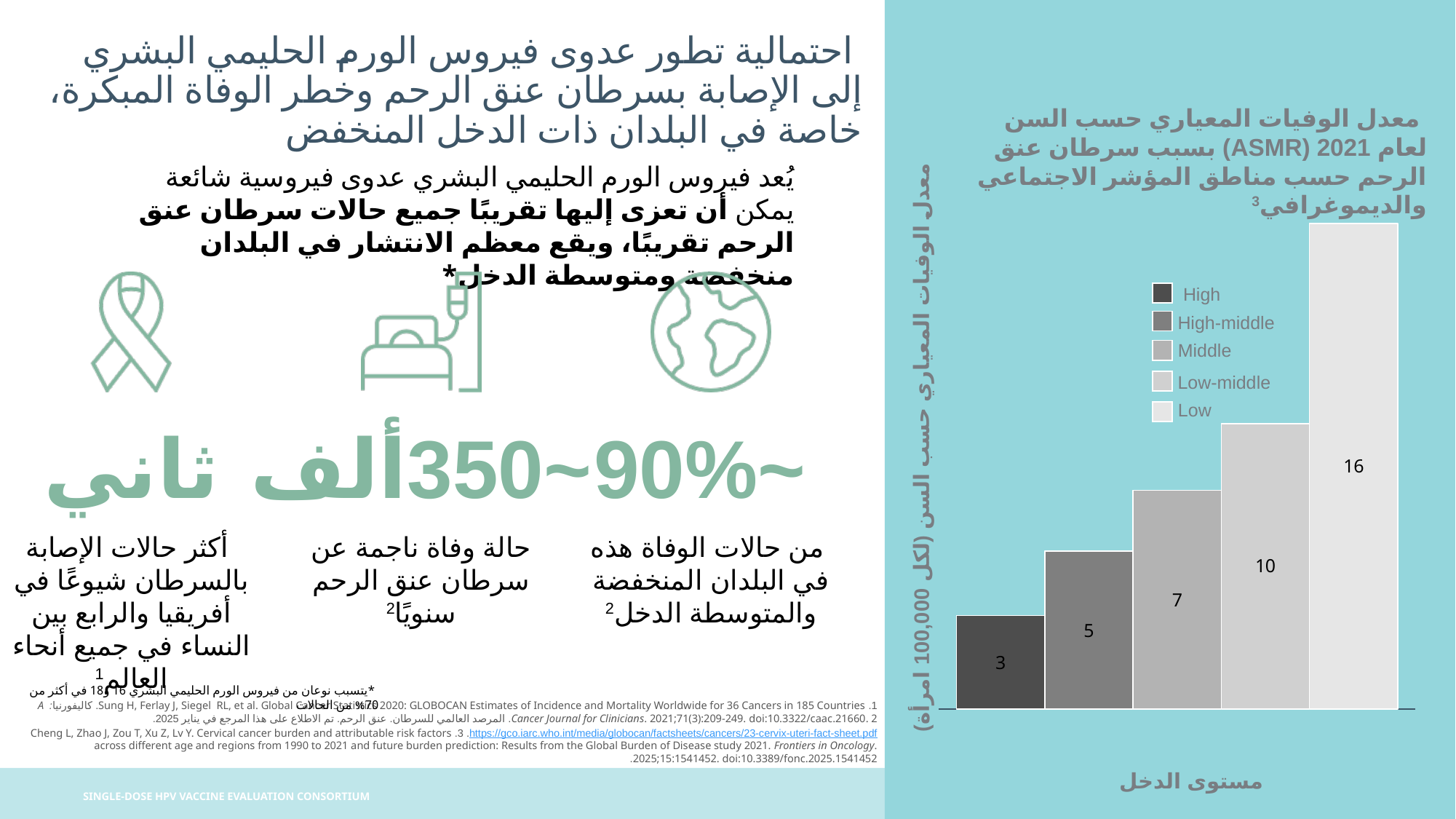
How many bars are plotted in the chart? 5 Do the values rise or fall moving from High to Low SDI along the x axis? Rise Which SDI region has the highest mortality rate in the chart? Low What value is shown for the Low-middle SDI region? 10 What is the age-standardised mortality rate shown for the High SDI region? 3 Which SDI region has the lowest mortality rate in the chart? High What value is shown for the Low SDI region? 16 Which has a larger value, High-middle or Low-middle? Low-middle What is the difference between the values for the Low and High SDI regions? 13 What value is shown for the Middle SDI region? 7 What type of chart is shown on the slide? Bar chart How many entries does the chart legend list? 5